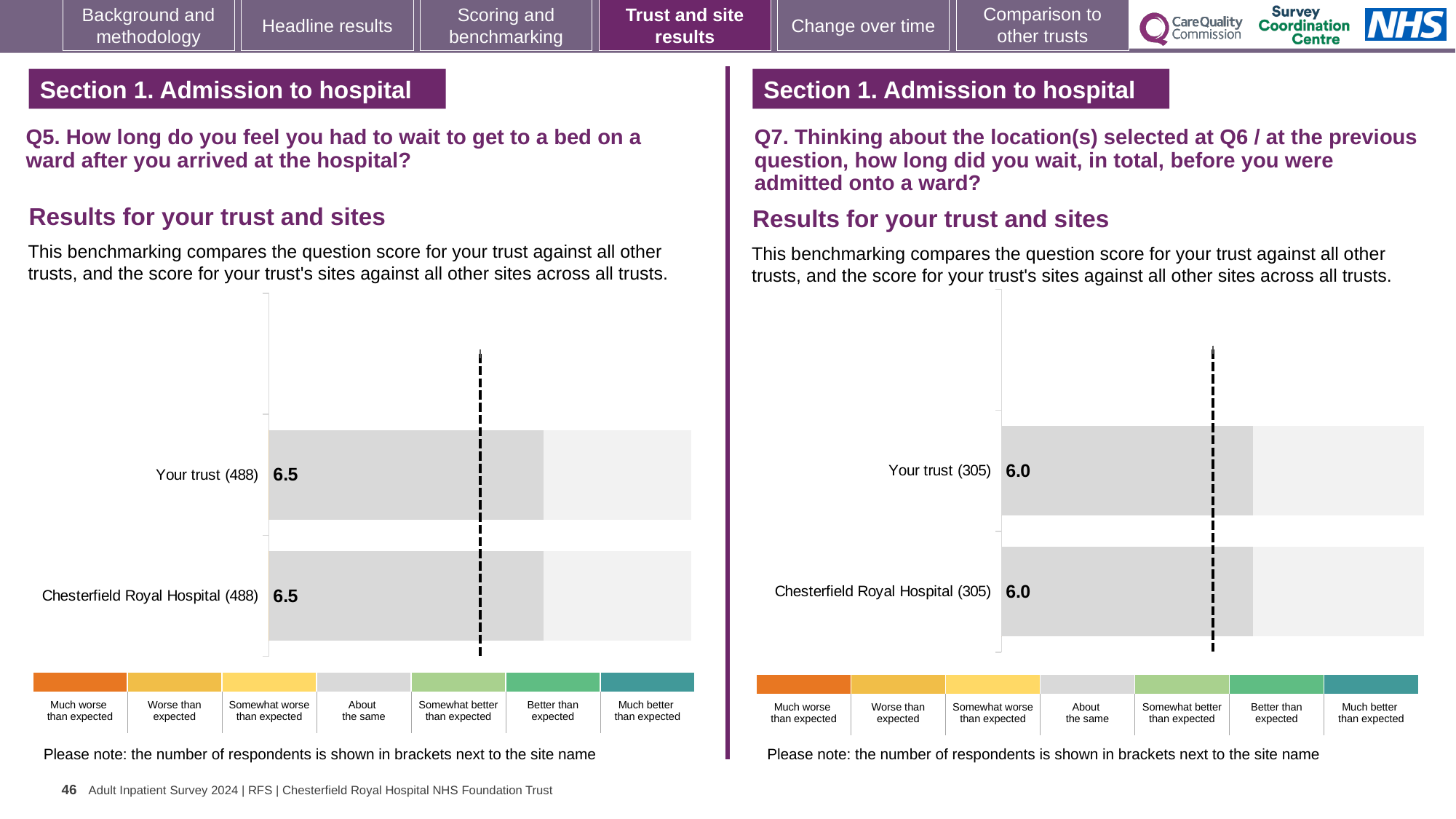
On the left chart (Q5), how many respondents are shown in brackets for Your trust? 488 How many categories does the colour key below the left chart (Q5) list? 7 On the right chart (Q7), how many respondents are shown in brackets for Chesterfield Royal Hospital? 305 On the right chart (Q7), what is the score for Chesterfield Royal Hospital? 6.0 What kind of chart is used on the left side of the slide (Q5)? bar chart On the left chart (Q5), what is the difference between the score for Your trust and the score for Chesterfield Royal Hospital? 0.0 Is the score for Your trust on the left chart (Q5) larger or smaller than the score for Your trust on the right chart (Q7)? larger On the right chart (Q7), what is the score for Your trust? 6.0 How many bars are plotted on the right chart (Q7)? 2 On the left chart (Q5), what is the score for Chesterfield Royal Hospital? 6.5 On the left chart (Q5), what is the score for Your trust? 6.5 What is the difference between the Your trust score on the left chart (Q5) and the Your trust score on the right chart (Q7)? 0.5